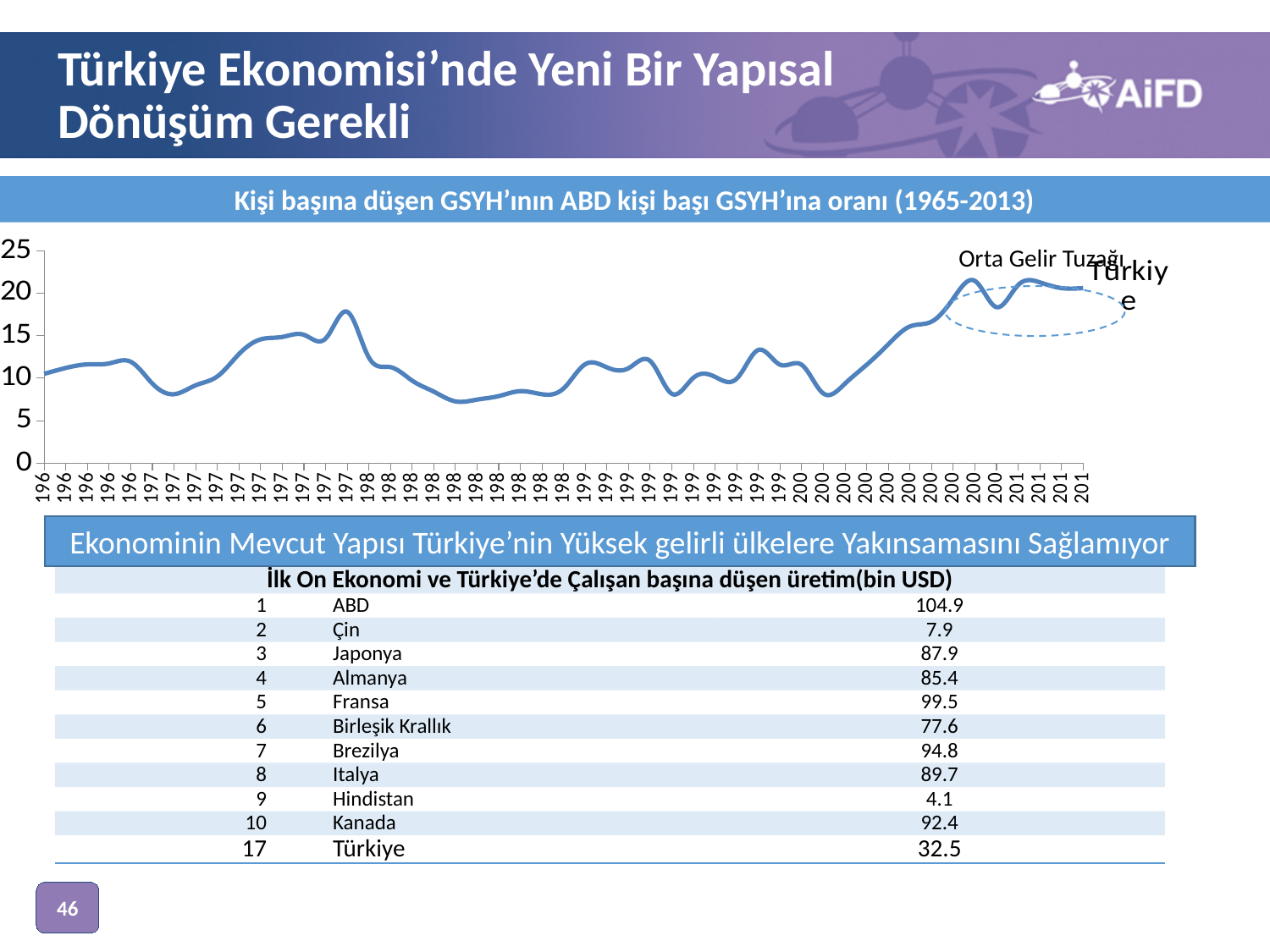
What is the maximum value shown on the chart's y axis? 25 Is the lowest point of the line greater or less than 10? less Which country does the line in the chart represent? Türkiye What is the title of the chart on the slide? Kişi başına düşen GSYH'ının ABD kişi başı GSYH'ına oranı (1965-2013) Is the value at the left end of the line (1965) greater or less than 15? less Is the value at the right end of the line (2013) greater or less than 15? greater Is the value at the right end of the line higher or lower than the value at the left end? higher Overall, does the line rise or fall from the left end to the right end of the x axis? rises What kind of chart is shown on the slide? line chart